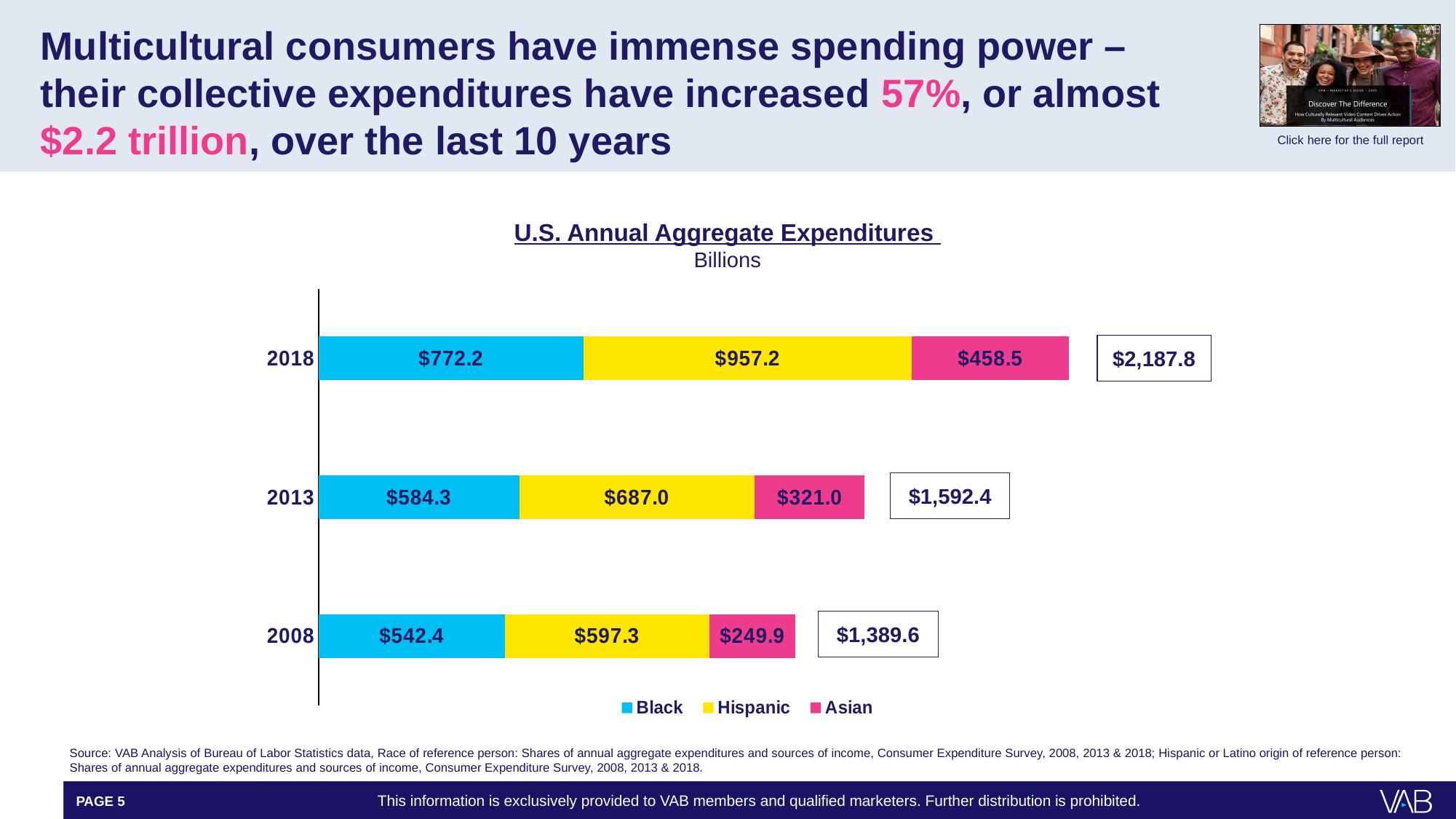
Which year has the lowest Asian expenditure value? 2008 How many years are shown on the chart? 3 What is the total of the stacked bar for 2008? $1,389.6 Which is larger in 2013, the Black value or the Hispanic value? Hispanic What is the title of the chart? U.S. Annual Aggregate Expenditures What is the Hispanic expenditure value for 2018? $957.2 How many series does the legend list? 3 Which year has the highest total aggregate expenditure? 2018 What is the Asian expenditure value for 2013? $321.0 What is the difference between the Hispanic values for 2018 and 2013? $270.2 What is the Black expenditure value for 2008? $542.4 What kind of chart is shown? Stacked bar chart